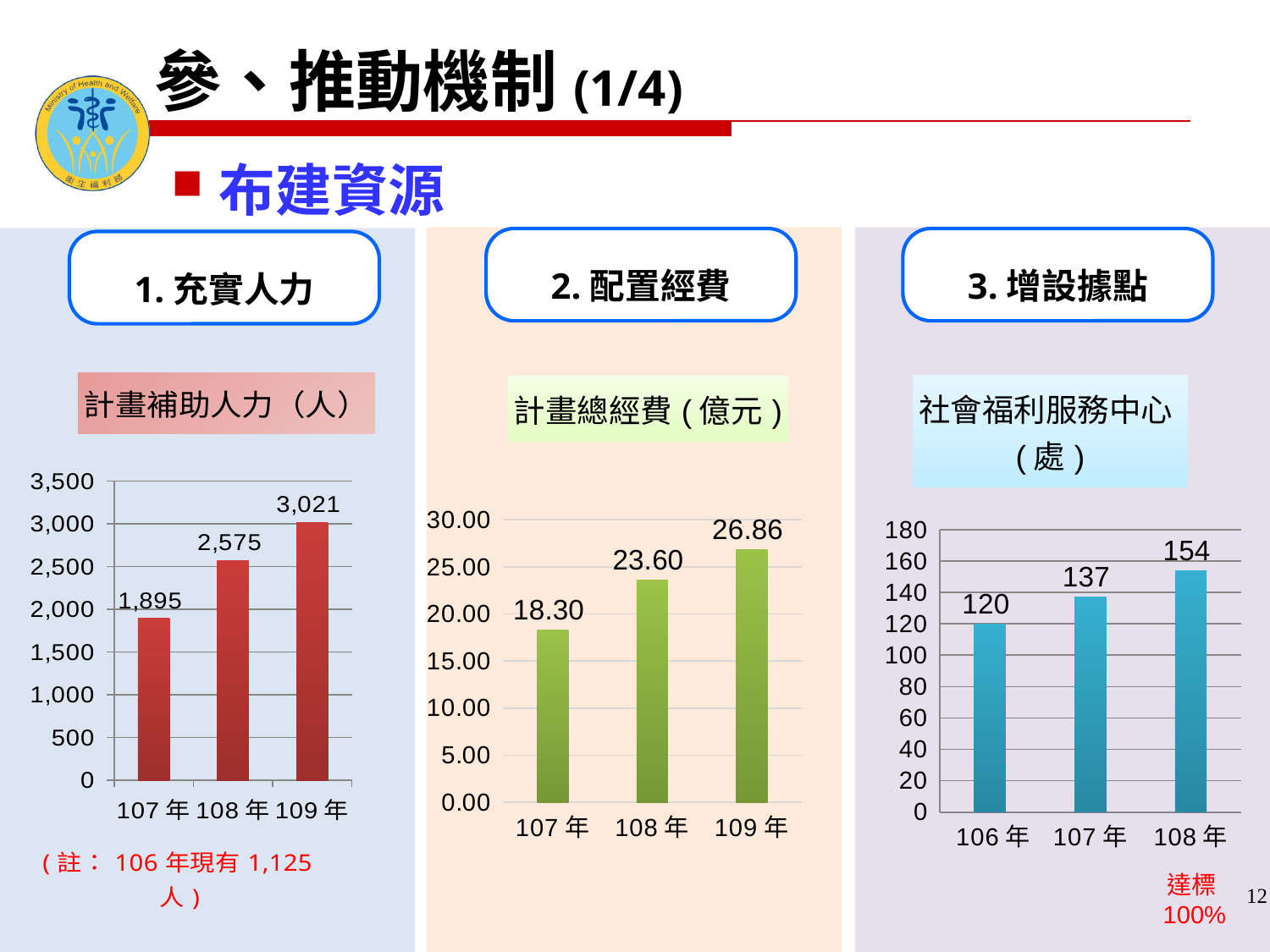
In the 計畫補助人力（人） chart, what is the value for 108 年? 2,575 In the 社會福利服務中心 ( 處 ) chart, which is larger, 106 年 or 108 年? 108 年 In the 計畫補助人力（人） chart, what is the difference between 109 年 and 107 年? 1,126 In the 計畫補助人力（人） chart, which year has the highest value? 109 年 In the 計畫總經費 ( 億元 ) chart, what is the difference between 109 年 and 108 年? 3.26 In the 社會福利服務中心 ( 處 ) chart, what is the difference between 108 年 and 106 年? 34 In the 社會福利服務中心 ( 處 ) chart, what is the value for 107 年? 137 In the 計畫總經費 ( 億元 ) chart, do the values rise or fall from 107 年 to 109 年? rise In the 計畫總經費 ( 億元 ) chart, what is the value for 107 年? 18.30 In the 計畫總經費 ( 億元 ) chart, which year has the lowest value? 107 年 What type of chart is the 社會福利服務中心 ( 處 ) chart? bar chart In the 計畫補助人力（人） chart, how many bars are plotted? 3